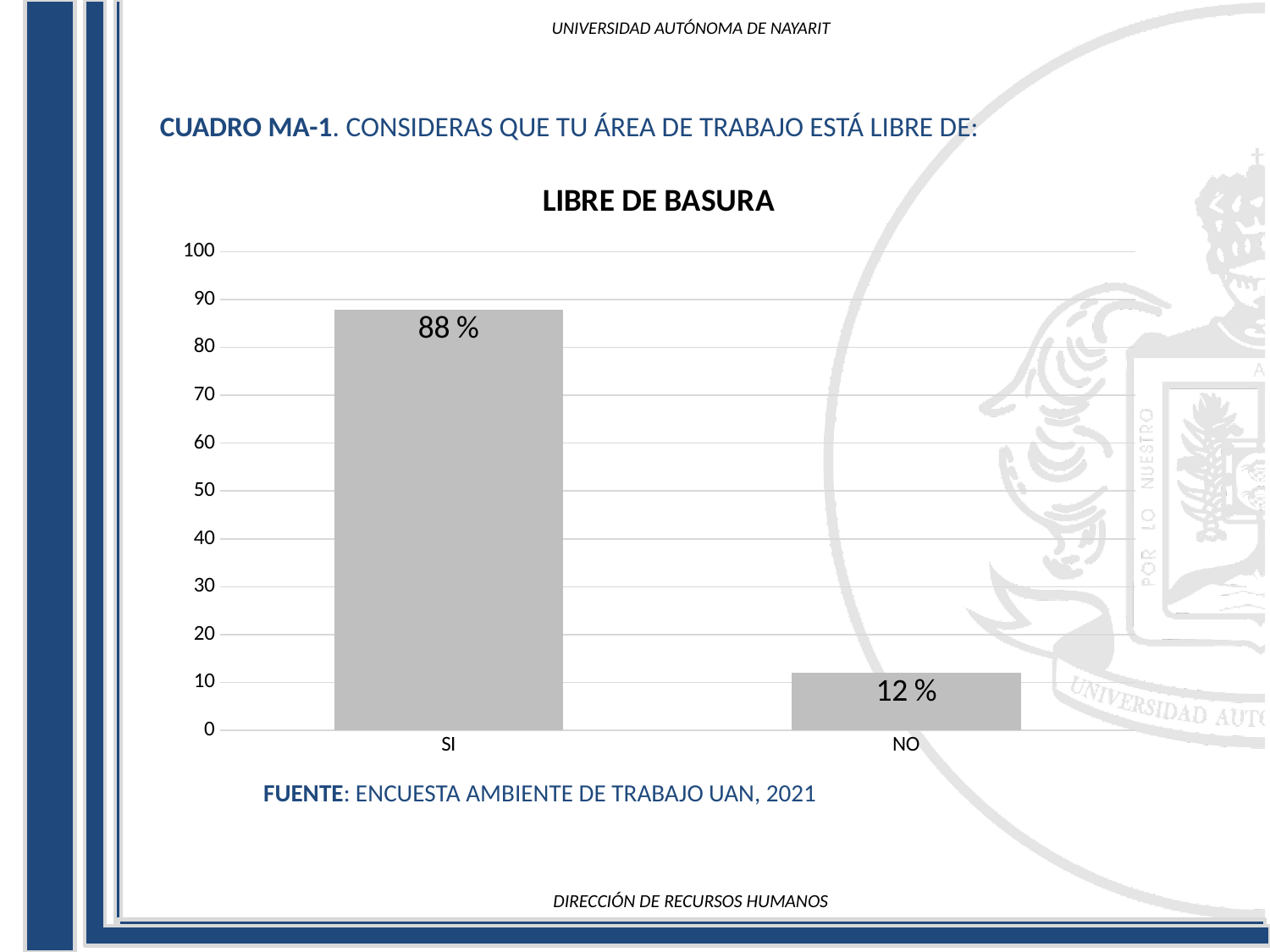
What kind of chart is shown? bar chart Is the value for SI greater or less than 80? greater How many categories are shown on the x axis? 2 Which category has the lowest value? NO Which is larger, the value for SI or the value for NO? SI Which category has the highest value? SI What is the value for SI? 88 % What is the highest value shown on the y axis? 100 What is the value for NO? 12 % What is the difference between the values for SI and NO? 76 % What is the title of the chart? LIBRE DE BASURA Is the value for NO greater or less than 20? less